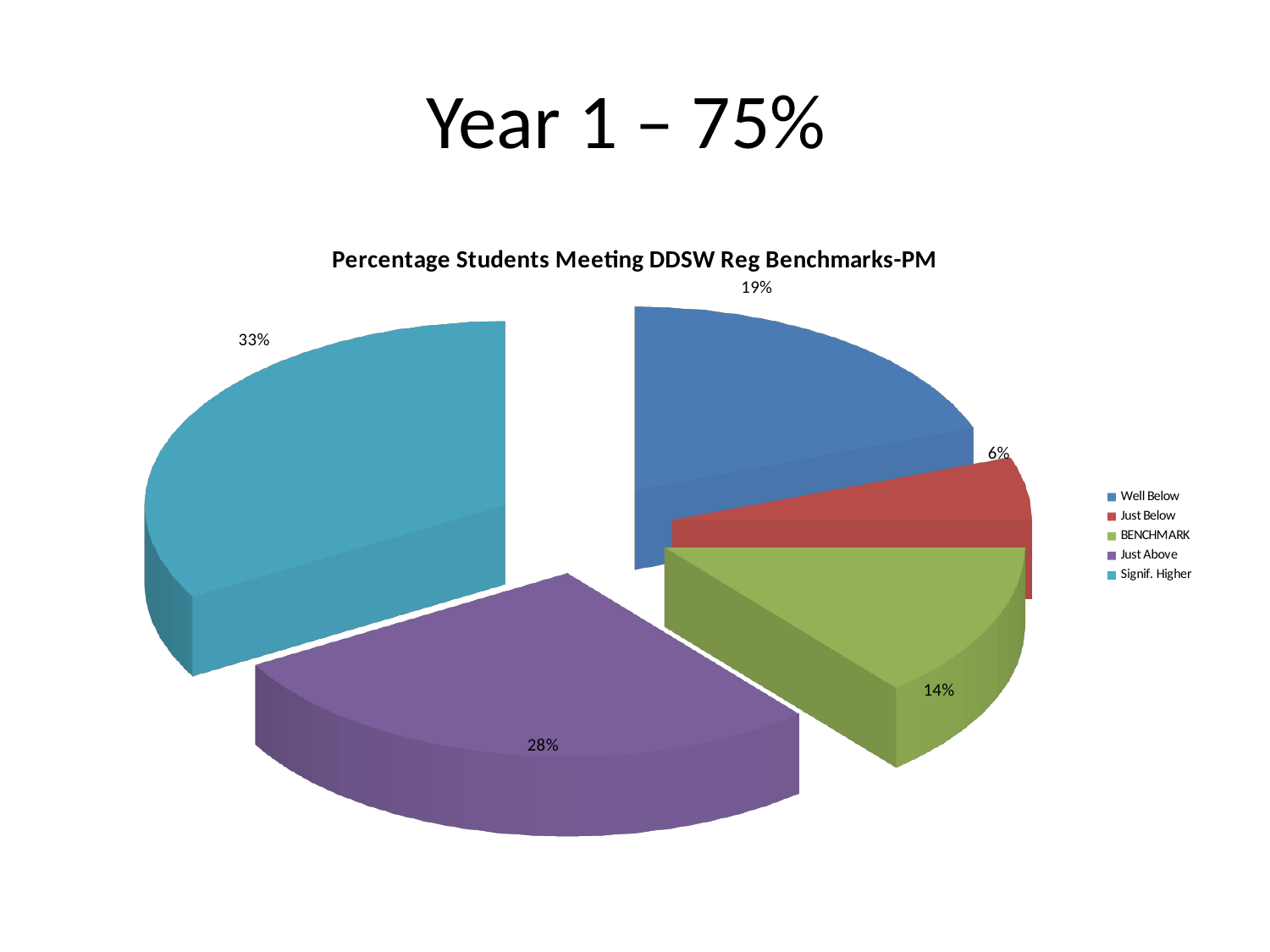
Which category has the largest share of the pie? Signif. Higher What percentage of students are in the Just Below category? 6% What kind of chart is shown on the slide? Pie chart What percentage of students are in the Well Below category? 19% How many categories does the legend list? 5 What percentage of students are in the Signif. Higher category? 33% Which is larger, the Just Above slice or the BENCHMARK slice? Just Above What is the difference in percentage points between the Signif. Higher and Well Below slices? 14 What is the title of the chart? Percentage Students Meeting DDSW Reg Benchmarks-PM What percentage of students are at BENCHMARK? 14% Which category has the smallest share of the pie? Just Below What percentage of students are in the Just Above category? 28%